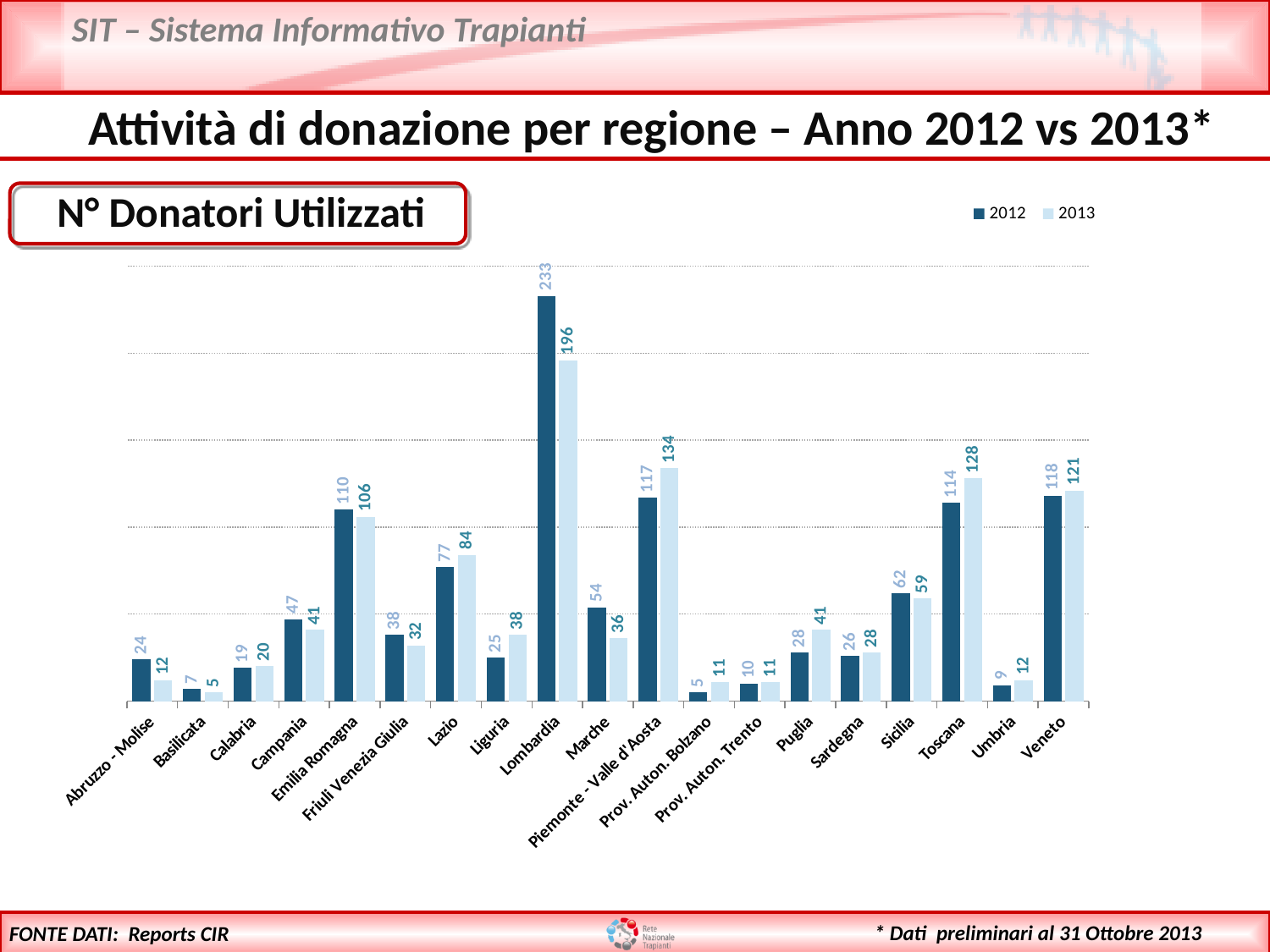
Which region has the lowest value in 2013? Basilicata What kind of chart is shown? Bar chart Which is larger for Liguria: the 2012 value or the 2013 value? 2013 How many regions are shown on the x axis? 19 What is the value for Lombardia in 2012? 233 What is the value for Toscana in 2013? 128 Which region has the highest value in 2012? Lombardia What is the value for Piemonte - Valle d'Aosta in 2013? 134 How many series does the legend list? 2 What is the difference between the 2012 and 2013 values for Puglia? 13 What is the difference between the 2012 and 2013 values for Lombardia? 37 Which is larger for Marche: the 2012 value or the 2013 value? 2012